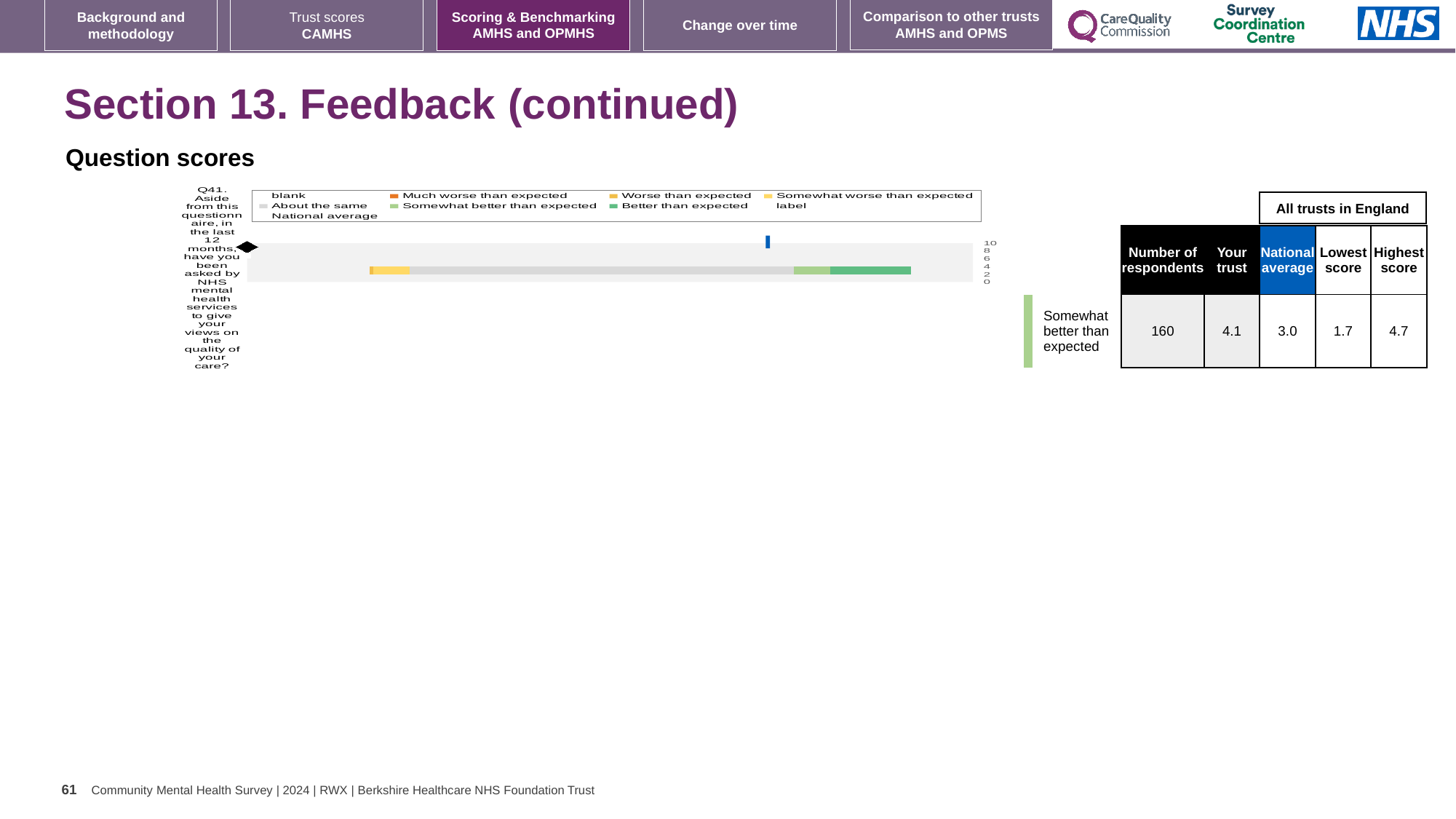
What is the difference between the trust's score and the national average for Q41? 1.1 What is the highest score among all trusts in England for Q41? 4.7 Which is larger for Q41, the trust's score or the national average? the trust's score How many respondents answered Q41? 160 What is the lowest score among all trusts in England for Q41? 1.7 What is the difference between the highest and lowest scores among all trusts in England for Q41? 3.0 Which colour in the chart legend represents 'Better than expected'? green What is the 'Your trust' score for Q41 shown on this slide? 4.1 How many survey questions are plotted in the chart on this slide? 1 What is the national average score for Q41 shown on this slide? 3.0 What kind of chart is shown for Q41 on this slide? bar chart Which benchmark category is the trust's Q41 result placed in? Somewhat better than expected